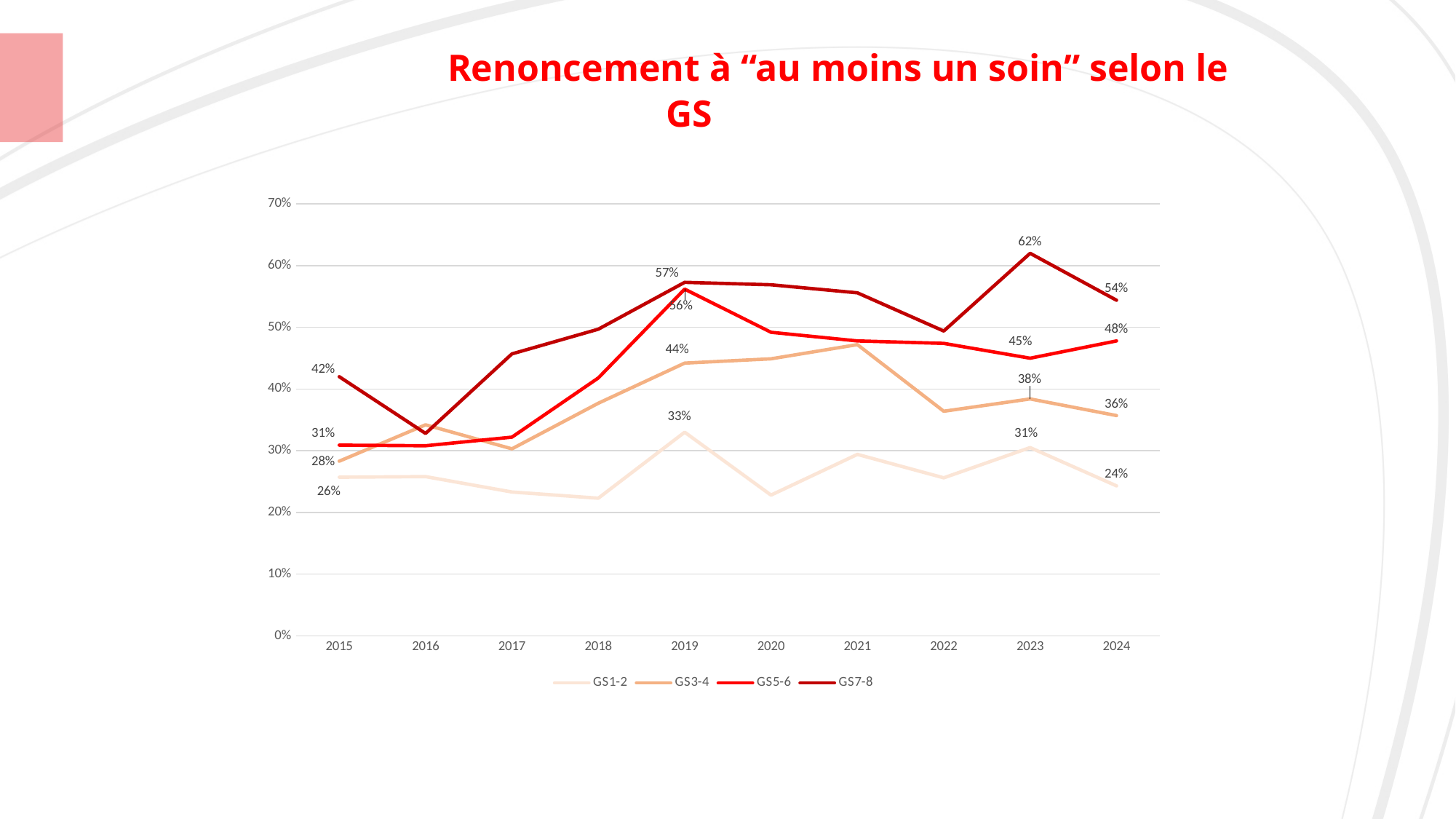
Which series has the lowest value in 2023? GS1-2 What is the value for GS1-2 in 2024? 24% What type of chart is shown on the slide? line chart Which series has the highest value in 2024? GS7-8 Is the value for GS3-4 in 2021 greater or less than 40%? greater What is the value for GS7-8 in 2023? 62% What is the value for GS5-6 in 2015? 31% Which is larger in 2015, the value for GS3-4 or the value for GS1-2? GS3-4 What is the value for GS3-4 in 2019? 44% What is the difference between the GS7-8 value and the GS5-6 value in 2023? 17% How many years are shown on the x axis? 10 How many series does the legend list? 4